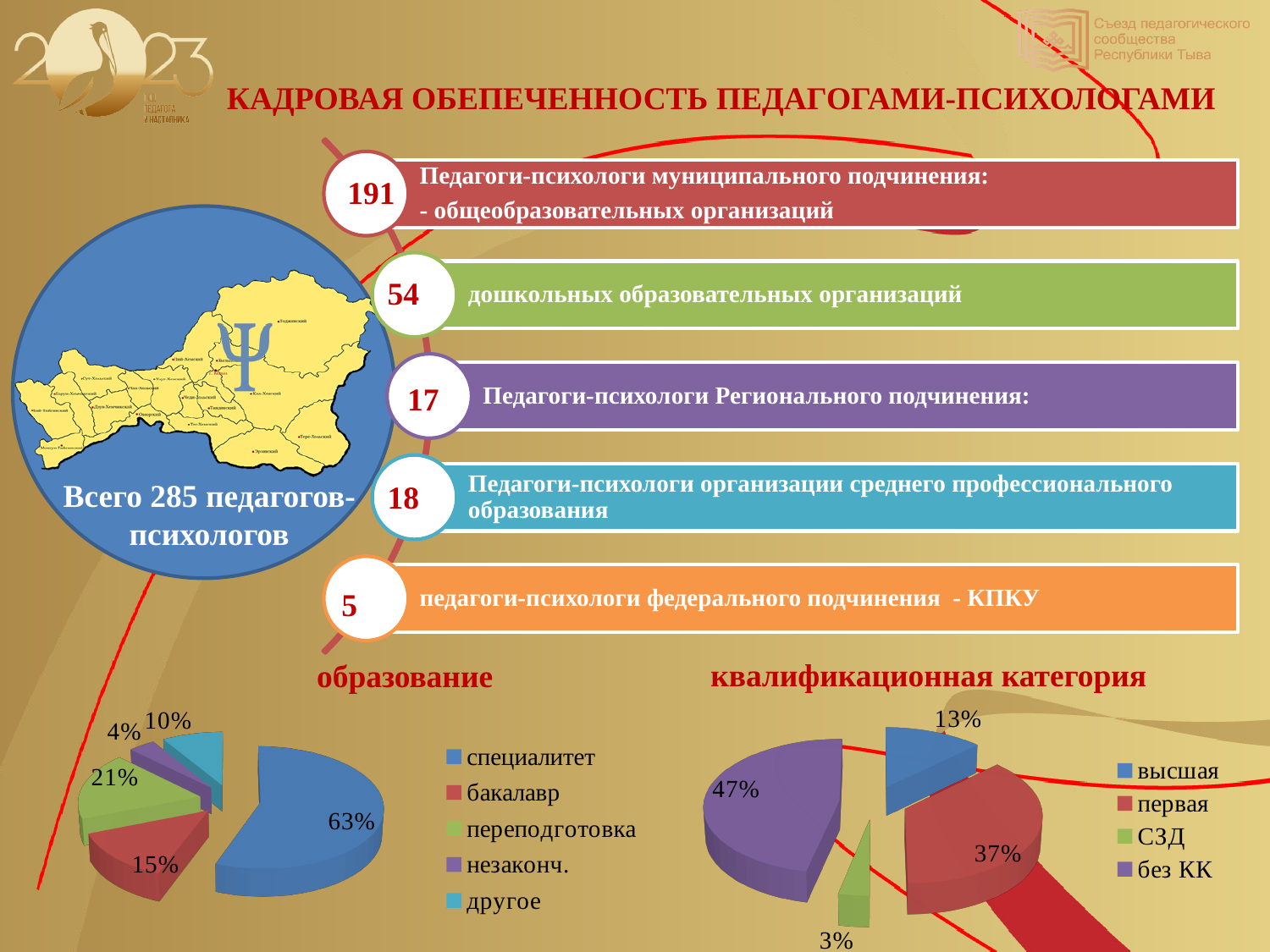
In the 'квалификационная категория' pie chart, what share is labelled for первая? 37% In the 'образование' pie chart, which is larger: бакалавр or другое? бакалавр In the 'образование' pie chart, which category has the smallest share? незаконч. In the 'квалификационная категория' pie chart, what colour is the slice for высшая? blue In the 'квалификационная категория' pie chart, which category has the largest share? без КК What type of chart is used for 'квалификационная категория'? pie chart In the 'образование' pie chart, what share is labelled for специалитет? 63% In the 'образование' pie chart, what share is labelled for переподготовка? 21% In the 'квалификационная категория' pie chart, what share is labelled for СЗД? 3% In the 'квалификационная категория' pie chart, what is the difference between the shares for без КК and высшая? 34% In the 'образование' pie chart, which category has the largest share? специалитет In the 'образование' pie chart, how many categories does the legend list? 5